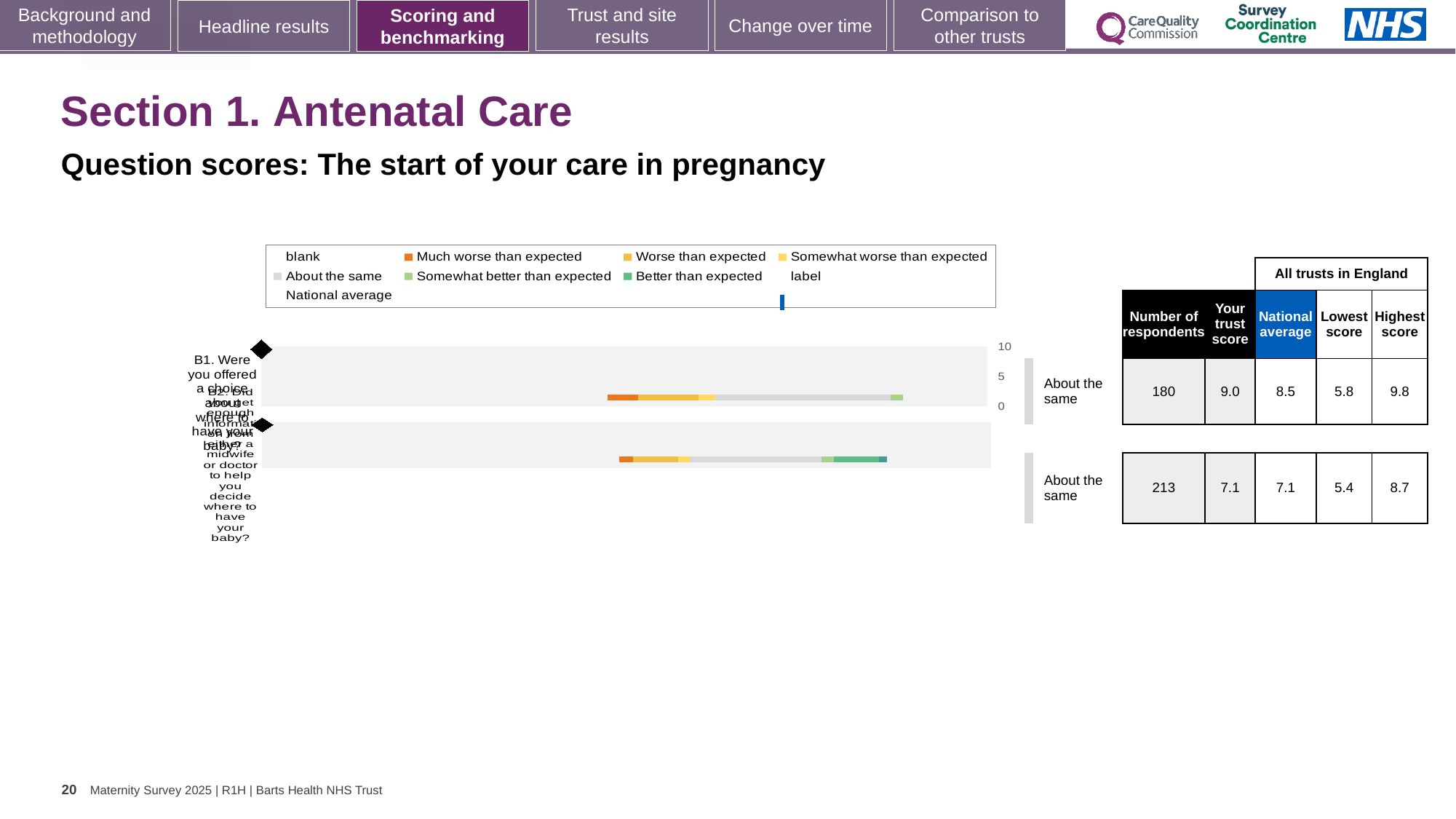
How many questions (bars) are plotted in the chart? 2 What kind of chart is shown on the slide? bar chart What benchmark category is shown for question B1? About the same How many respondents answered question B2? 213 Which question has the higher trust score, B1 or B2? B1 What is the 'Your trust score' for question B1 (Were you offered a choice about where to have your baby?)? 9.0 What is the difference between the highest and lowest scores for question B2? 3.3 What is the national average for question B1? 8.5 What colour does the legend use for 'Much worse than expected'? orange What is the highest score among all trusts in England for question B2? 8.7 By how much does the trust score for B1 exceed the national average for B1? 0.5 What is the lowest score among all trusts in England for question B1? 5.8